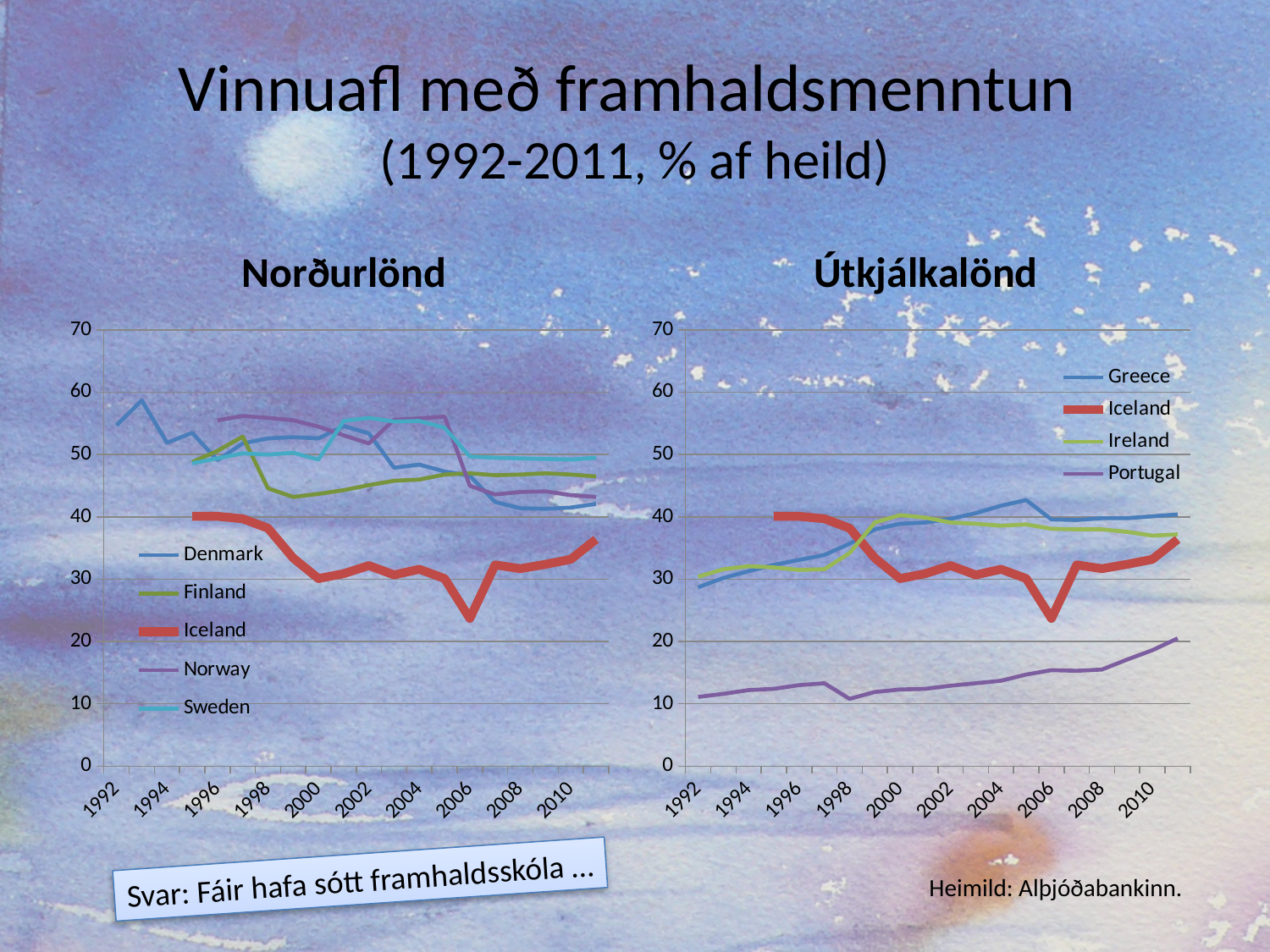
In the Útkjálkalönd chart, does the value for Portugal rise or fall from 1992 to 2011? rise In the Norðurlönd chart, is the value for Iceland in 2006 greater or less than 30? less How many series does the legend of the Útkjálkalönd chart list? 4 How many series does the legend of the Norðurlönd chart list? 5 In the Norðurlönd chart, which country has the lowest values throughout the period? Iceland In the Útkjálkalönd chart, is the value for Portugal in 1992 greater or less than 20? less In the Norðurlönd chart, is the value for Denmark in 1992 greater or less than 50? greater In the Útkjálkalönd chart, which is higher in 2010, Iceland or Portugal? Iceland What kind of chart is the Norðurlönd chart on the left? line chart In the Útkjálkalönd chart, which country has the lowest values throughout the period? Portugal In the Norðurlönd chart, which is higher in 2000, Denmark or Iceland? Denmark What is the title of the chart on the right? Útkjálkalönd